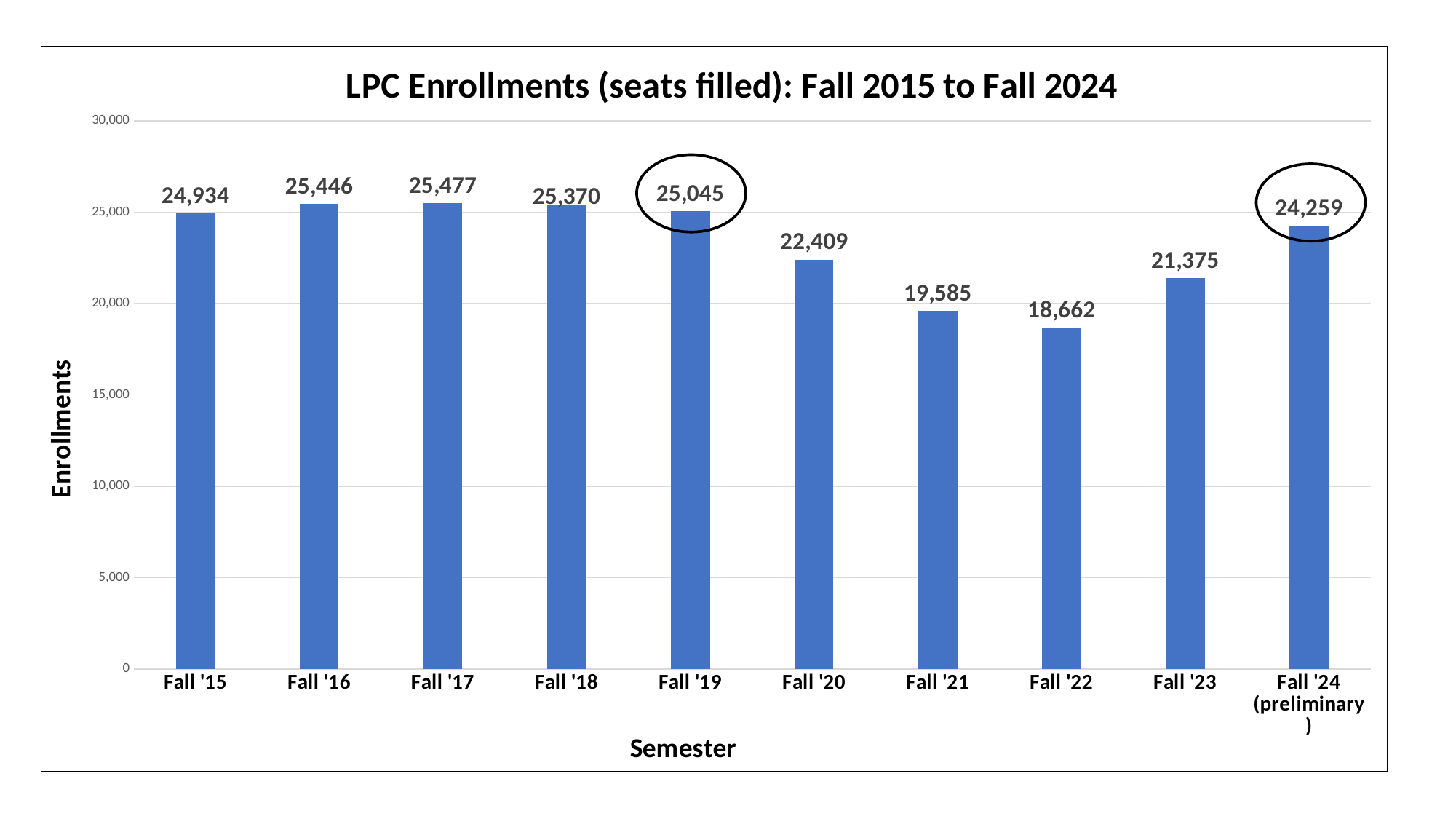
What is the enrollment value for Fall '24 (preliminary)? 24,259 What is the difference in enrollment between Fall '19 and Fall '24 (preliminary)? 786 Which semester has the highest enrollment? Fall '17 What is the enrollment value for Fall '19? 25,045 What is the difference in enrollment between Fall '23 and Fall '22? 2,713 What is the title of the chart? LPC Enrollments (seats filled): Fall 2015 to Fall 2024 How many semesters are shown on the chart? 10 What is the enrollment value for Fall '22? 18,662 Is the value for Fall '21 greater or less than 20,000? less Which has higher enrollment, Fall '20 or Fall '23? Fall '20 Which semester has the lowest enrollment? Fall '22 What kind of chart is this? Bar chart